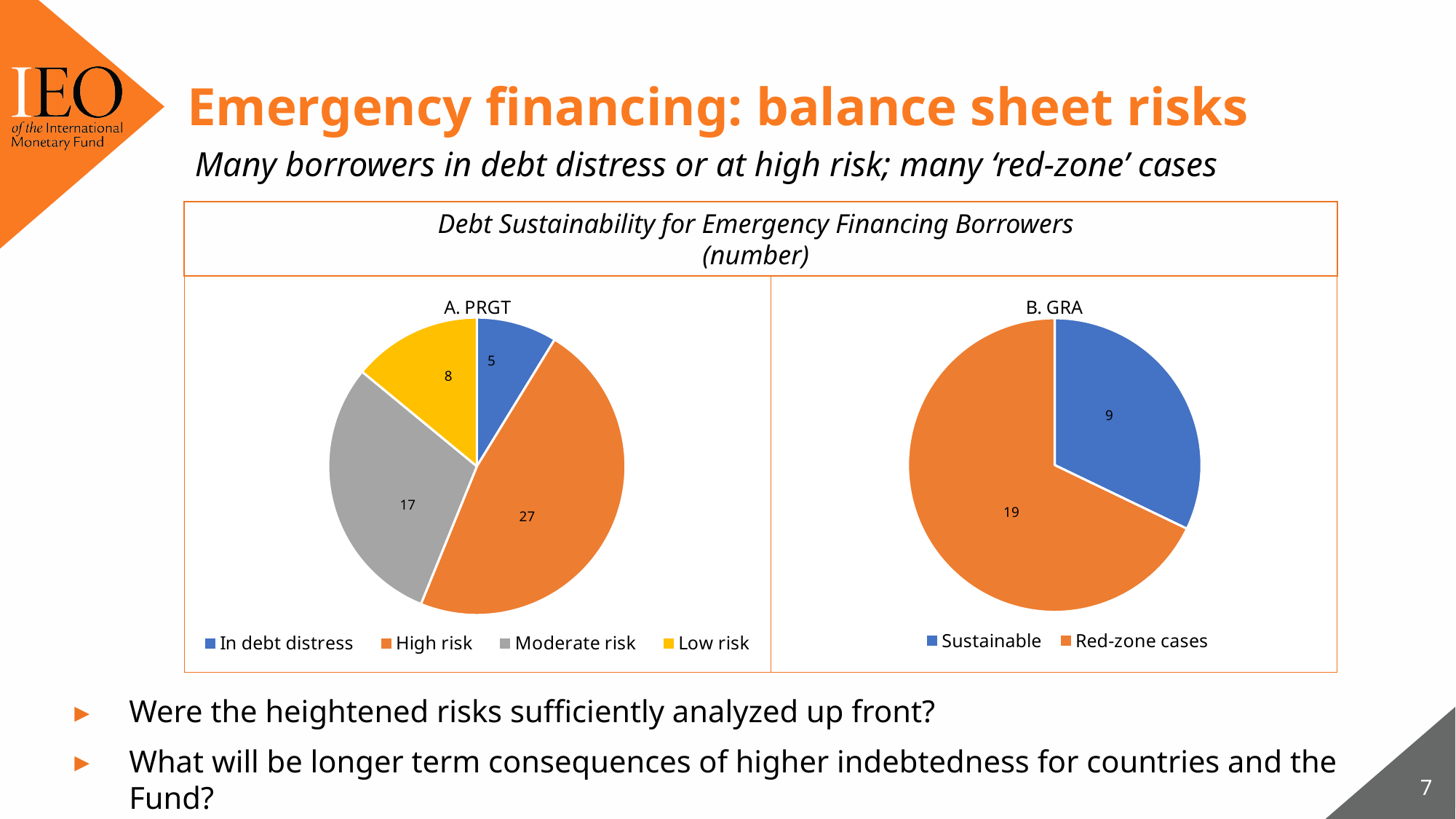
In the A. PRGT pie chart, how many borrowers are at high risk? 27 In the A. PRGT pie chart, what is the difference between the moderate risk and low risk values? 9 In the A. PRGT pie chart, which category has the largest slice? High risk In the A. PRGT pie chart, how many borrowers are in debt distress? 5 In the B. GRA pie chart, how many red-zone cases are there? 19 How many categories does the B. GRA pie chart show? 2 In the A. PRGT pie chart, which category has the smallest slice? In debt distress What is the title of the chart panel containing the two pie charts? Debt Sustainability for Emergency Financing Borrowers (number) In the B. GRA pie chart, which is larger: Sustainable or Red-zone cases? Red-zone cases How many categories does the A. PRGT pie chart show? 4 What type of chart is B. GRA? Pie chart What is the total number of borrowers shown in the A. PRGT pie chart? 57